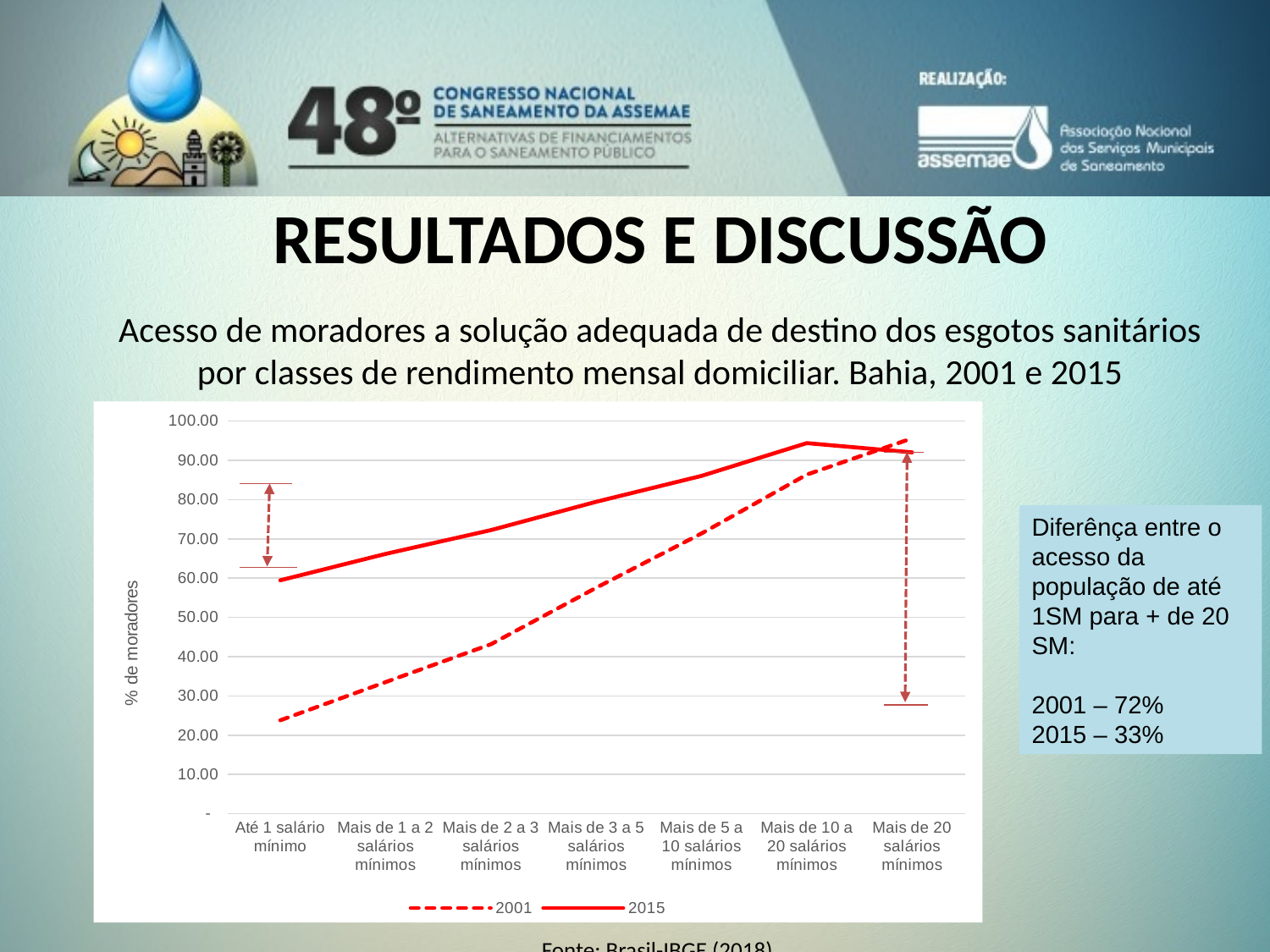
Do the values of the 2001 series rise or fall as you move from left to right along the x axis? rise How many series does the chart's legend list? 2 Which series is drawn with a dashed line in the chart? 2001 How many income categories are shown along the x axis of the chart? 7 What is the label of the vertical axis of the chart? % de moradores What kind of chart is shown on the slide? line chart Is the 2015 value for 'Mais de 3 a 5 salários mínimos' greater or less than 70.00? greater For 'Até 1 salário mínimo', which series has the larger value, 2001 or 2015? 2015 Is the 2001 value for 'Mais de 20 salários mínimos' greater or less than 90.00? greater Which income category has the lowest value in the 2001 series? Até 1 salário mínimo Is the 2001 value for 'Até 1 salário mínimo' greater or less than 30.00? less